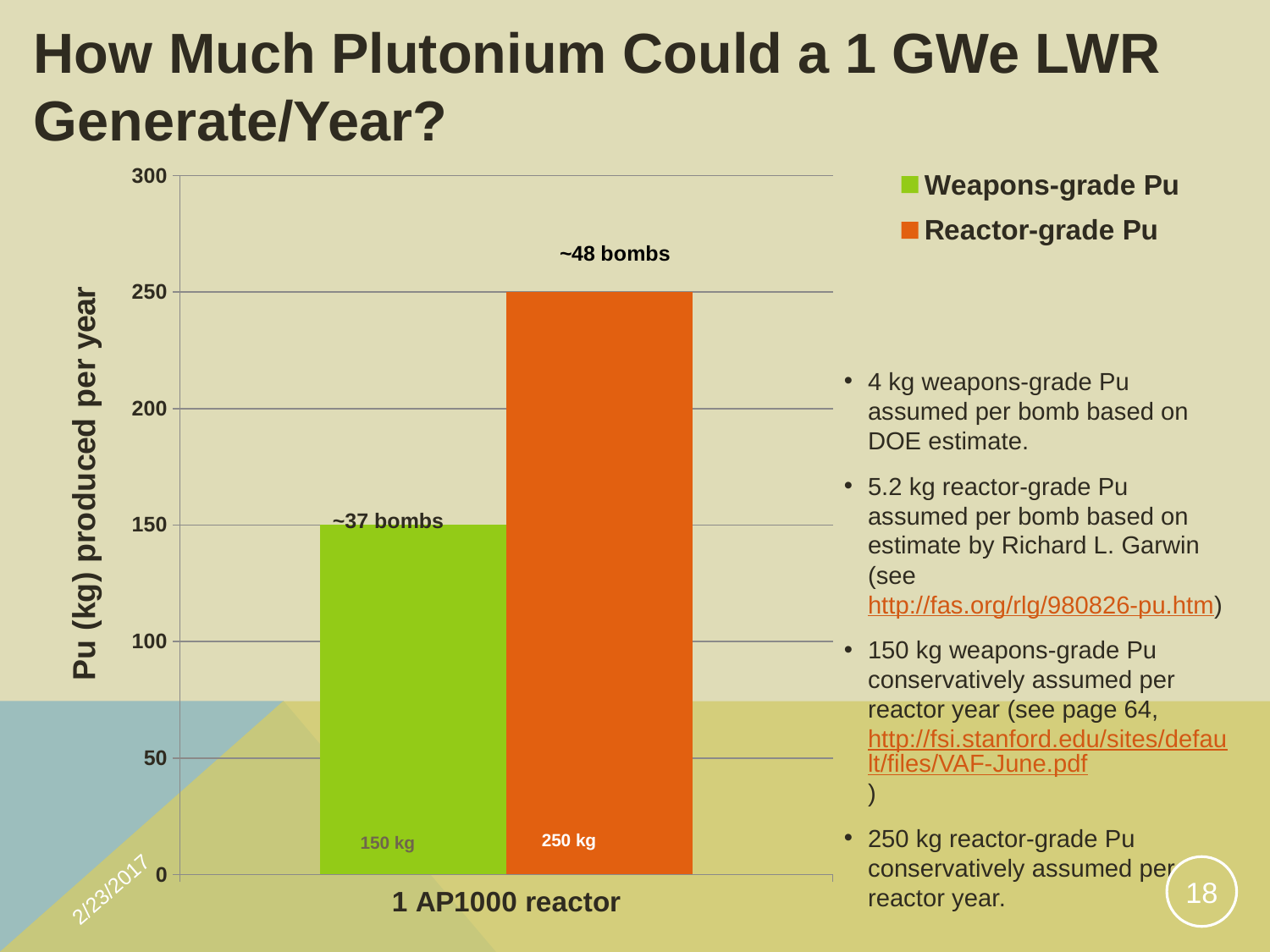
What kind of chart is shown on the slide? Bar chart How many series does the legend list? 2 What is the category label on the x axis? 1 AP1000 reactor Is the value for Reactor-grade Pu greater or less than 200? greater Which series has the lowest value? Weapons-grade Pu What value is shown for Reactor-grade Pu? 250 kg What is the approximate number of bombs labelled above the Weapons-grade Pu bar? ~37 bombs What value is shown for Weapons-grade Pu? 150 kg What is the label on the y axis? Pu (kg) produced per year What is the difference in kg between Reactor-grade Pu and Weapons-grade Pu? 100 kg What is the approximate number of bombs labelled above the Reactor-grade Pu bar? ~48 bombs Which series has the higher value, Weapons-grade Pu or Reactor-grade Pu? Reactor-grade Pu